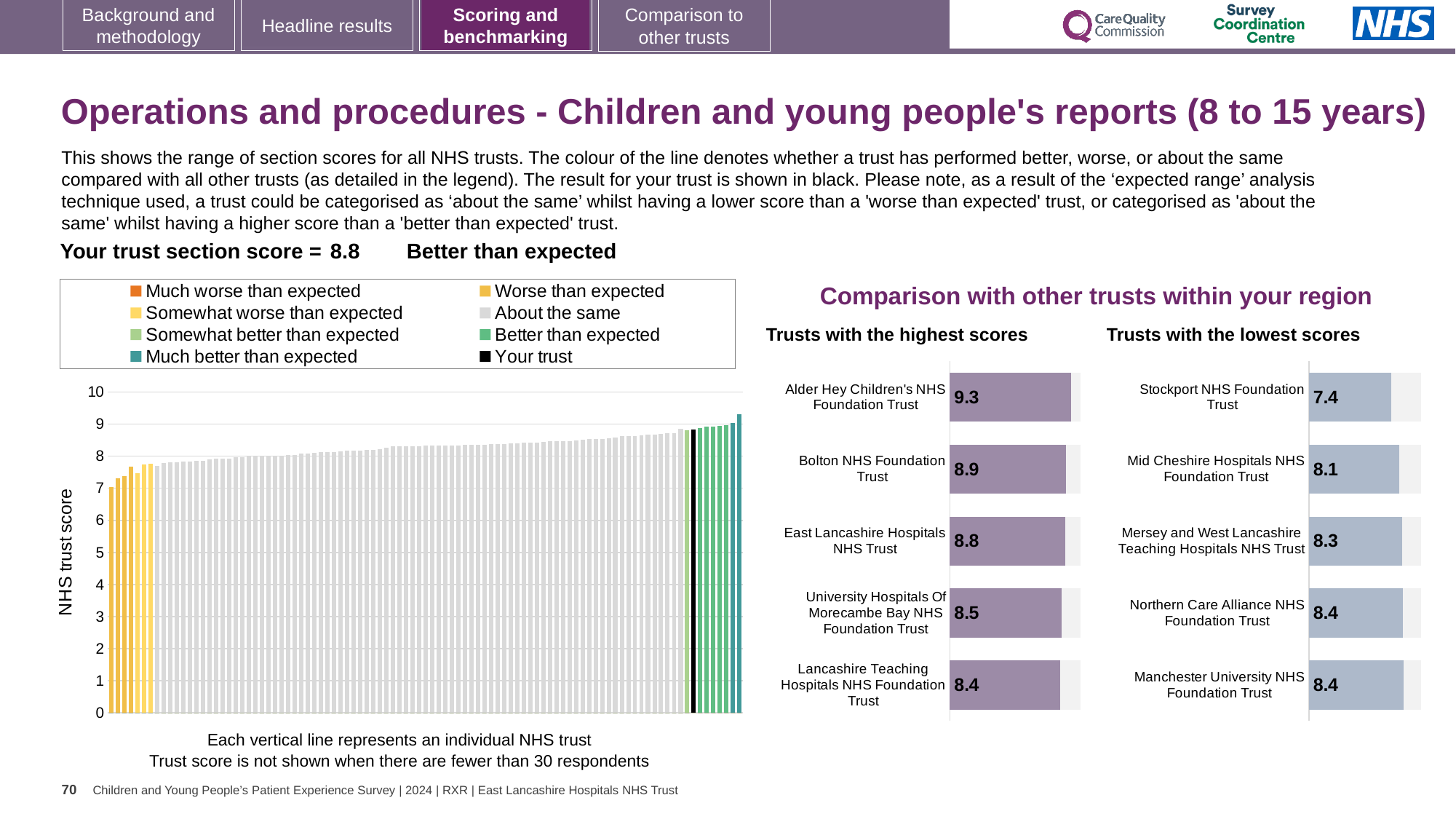
How many entries does the legend above the 'NHS trust score' chart list? 8 In the 'Trusts with the highest scores' chart, which trust has the highest score? Alder Hey Children's NHS Foundation Trust In the 'Trusts with the highest scores' chart, what is the score for Bolton NHS Foundation Trust? 8.9 In the 'Trusts with the lowest scores' chart, what is the score for Mersey and West Lancashire Teaching Hospitals NHS Trust? 8.3 In the 'Trusts with the lowest scores' chart, what is the score for Stockport NHS Foundation Trust? 7.4 How many trusts are shown in the 'Trusts with the highest scores' chart? 5 In the 'Trusts with the highest scores' chart, what is the score for Alder Hey Children's NHS Foundation Trust? 9.3 In the 'Trusts with the lowest scores' chart, which trust has the lowest score? Stockport NHS Foundation Trust In the 'Trusts with the highest scores' chart, what is the difference between the scores of Alder Hey Children's NHS Foundation Trust and Lancashire Teaching Hospitals NHS Foundation Trust? 0.9 What kind of chart is the 'NHS trust score' chart on the left of the slide? Bar chart In the 'Trusts with the lowest scores' chart, which has the larger score: Mid Cheshire Hospitals NHS Foundation Trust or Northern Care Alliance NHS Foundation Trust? Northern Care Alliance NHS Foundation Trust In the 'NHS trust score' chart on the left, do the bar values rise or fall from left to right? Rise